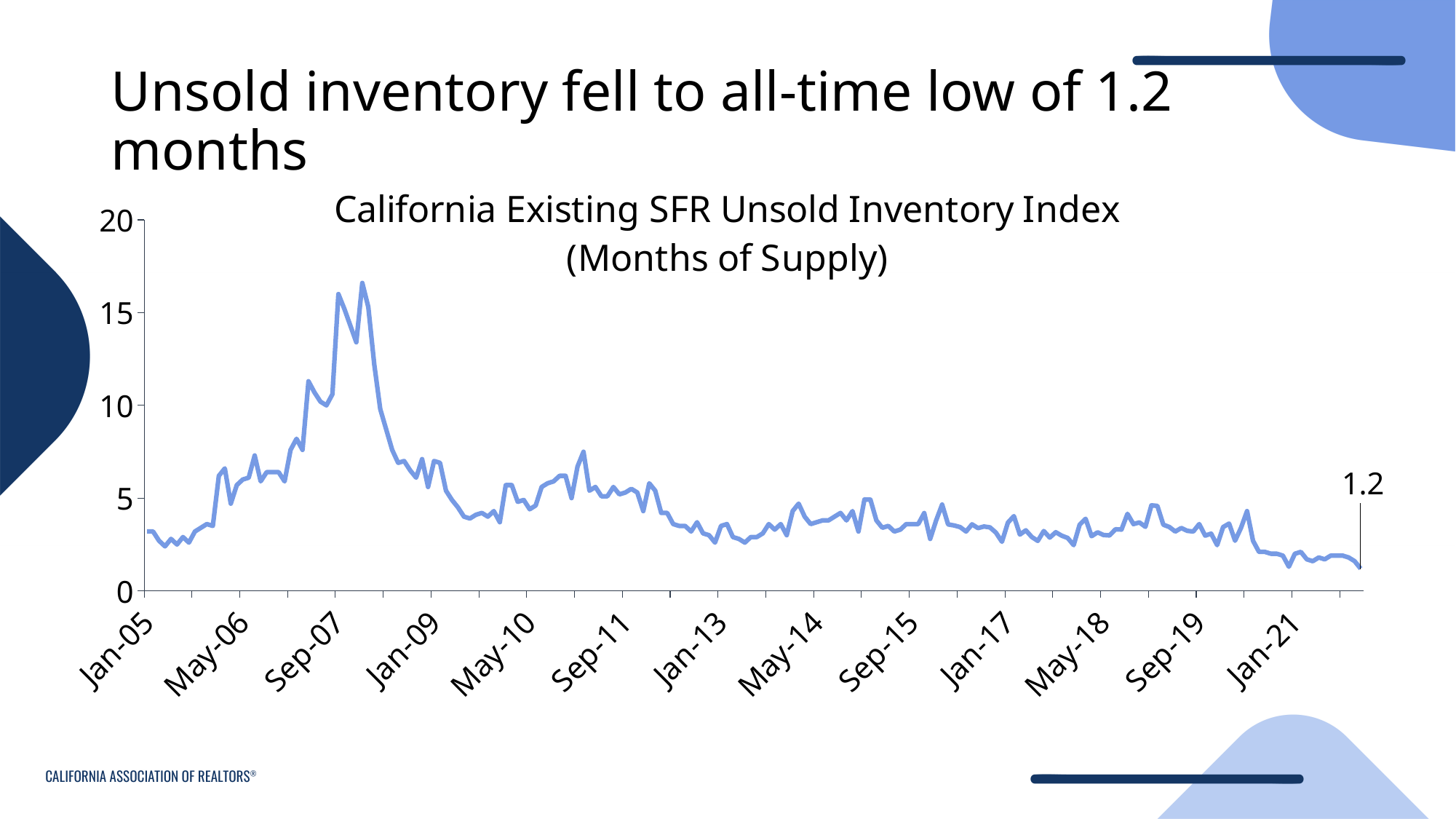
From Jan-21 to the end of the line, does the value generally rise or fall? fall Is the value at Jan-21 greater or less than 5? less What is the highest tick value shown on the vertical axis? 20 What is the value labelled at the end of the line? 1.2 What is the title of the chart? California Existing SFR Unsold Inventory Index (Months of Supply) Is the value at Jan-13 greater or less than 5? less What is the lowest value shown on the chart? 1.2 Is the highest point of the line greater or less than 15? greater From the peak of the line to Jan-09, does the value rise or fall? fall Does the highest point of the line occur before or after Jan-09? before What kind of chart is shown on the slide? line chart